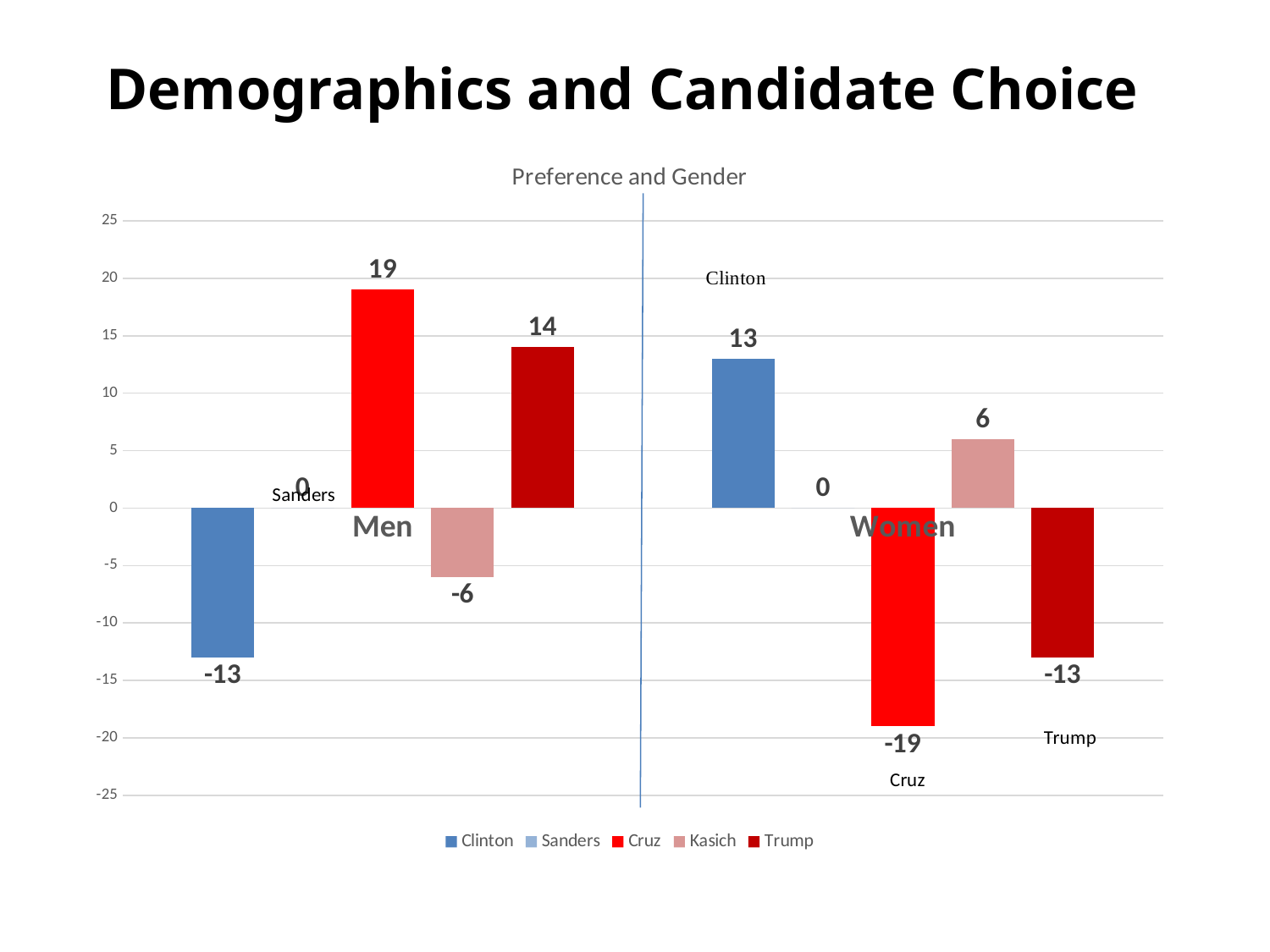
What is the difference between the Cruz value for Men and the Trump value for Men? 5 What is the value for Kasich among Men? -6 How many series does the legend list? 5 What is the value for Clinton among Women? 13 What is the value for Trump among Women? -13 Which is larger, the Clinton value for Women or the Kasich value for Women? Clinton What kind of chart is shown on the slide? Bar chart How many gender categories are shown on the x axis? 2 Which candidate has the highest value among Men? Cruz Which candidate has the lowest value among Women? Cruz What is the title of the chart? Preference and Gender What is the value for Cruz among Men? 19